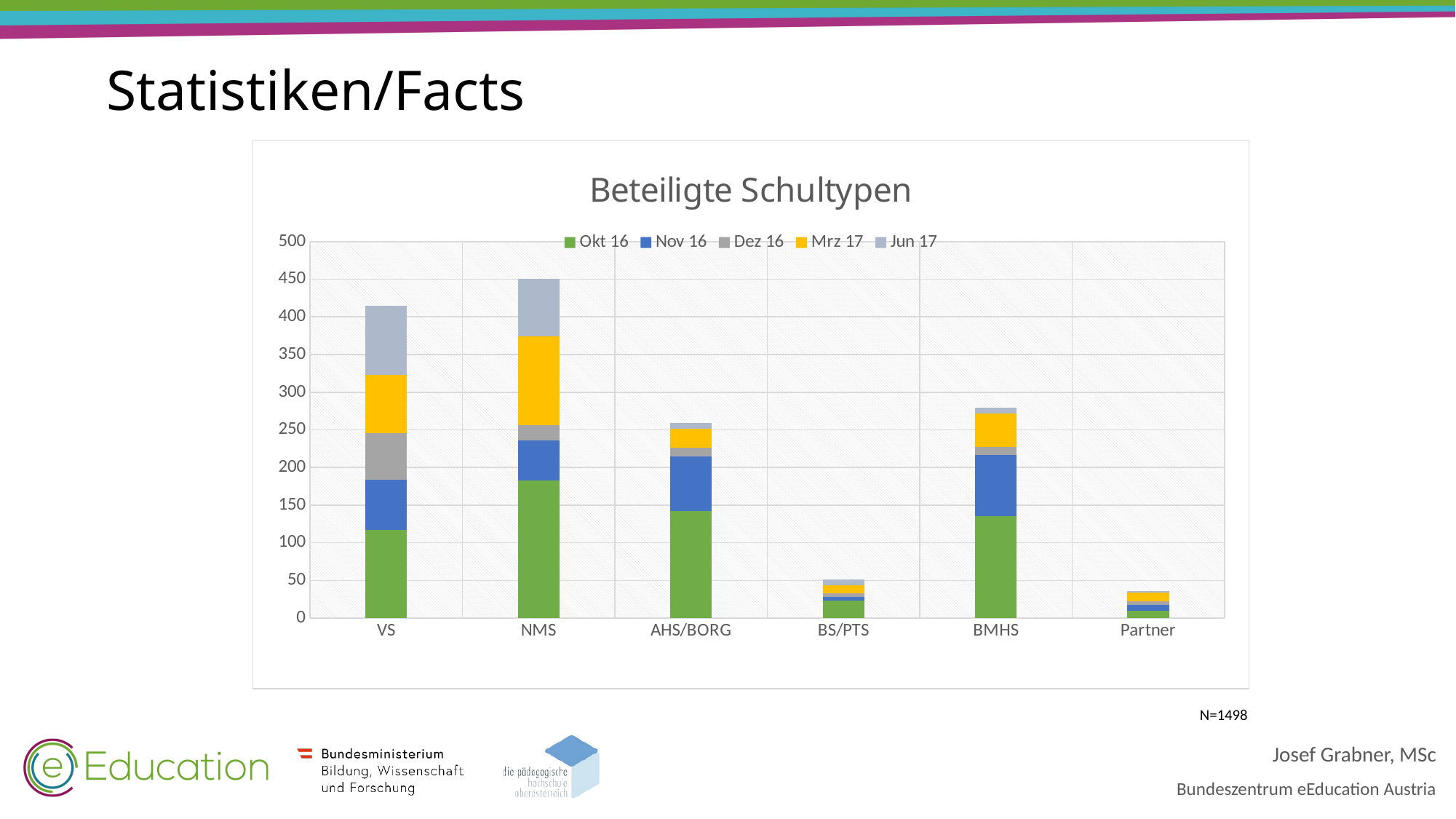
Which category has the lowest total stacked bar? Partner Is the Okt 16 segment for NMS greater or less than 150? greater How many school-type categories are shown on the x axis? 6 Is the total bar for NMS greater or less than 400? greater Which category has the highest total stacked bar? NMS Which has a larger total bar, VS or BMHS? VS Is the total bar for BMHS greater or less than 300? less How many series does the legend list? 5 What is the title of the chart? Beteiligte Schultypen Which series is shown in yellow in the legend? Mrz 17 What kind of chart is shown on the slide? stacked bar chart